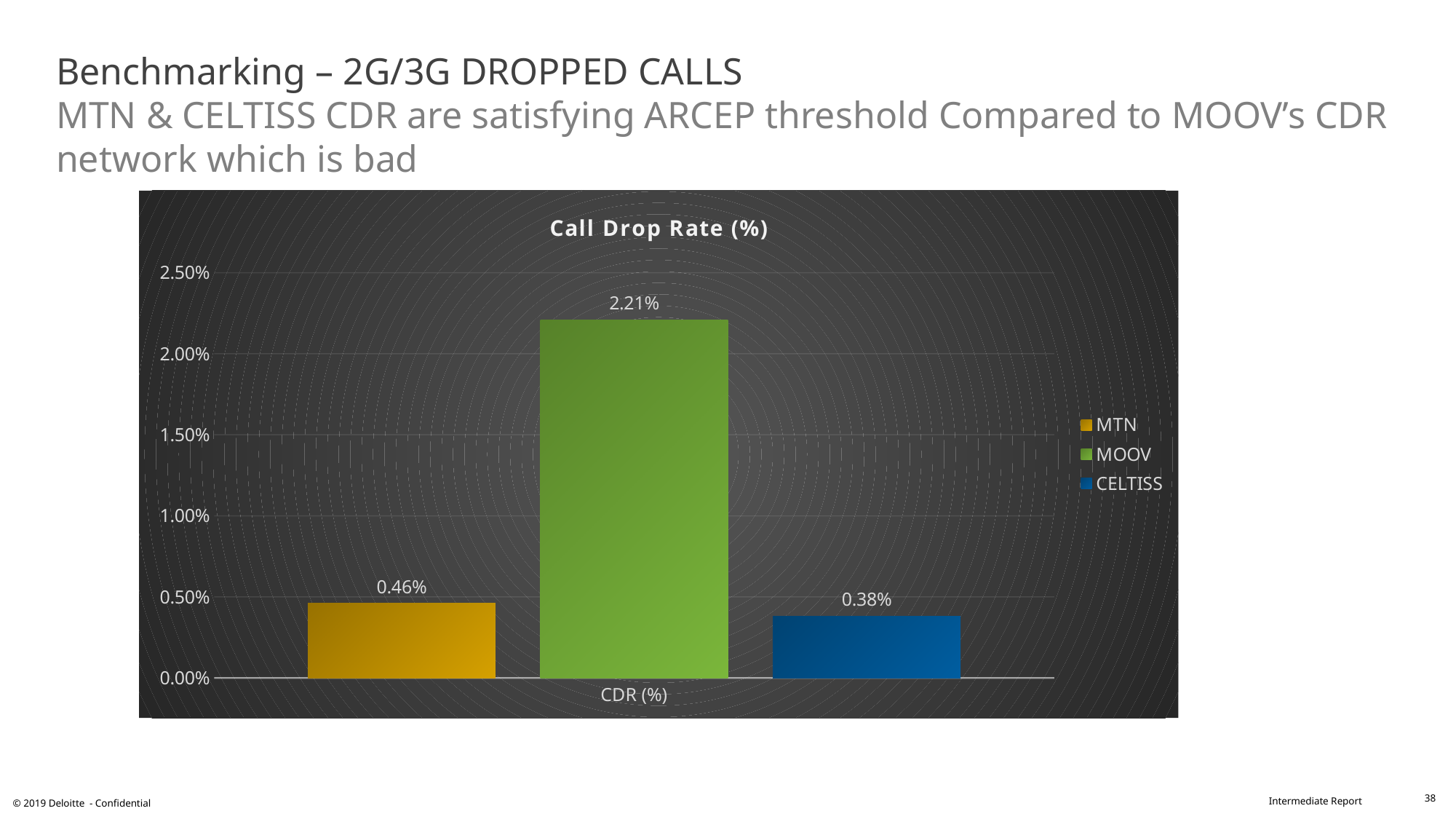
What is the call drop rate for CELTISS? 0.38% What is the call drop rate for MTN? 0.46% What kind of chart is shown on the slide? Bar chart What is the difference between MTN's and CELTISS's call drop rates? 0.08% Which operator has the highest call drop rate? MOOV What is the title of the chart? Call Drop Rate (%) What is the difference between MOOV's and MTN's call drop rates? 1.75% Is the value for MOOV greater or less than 2.00%? greater What is the call drop rate for MOOV? 2.21% Which operator has the lowest call drop rate? CELTISS How many series does the legend list? 3 Which has a higher call drop rate, MTN or CELTISS? MTN